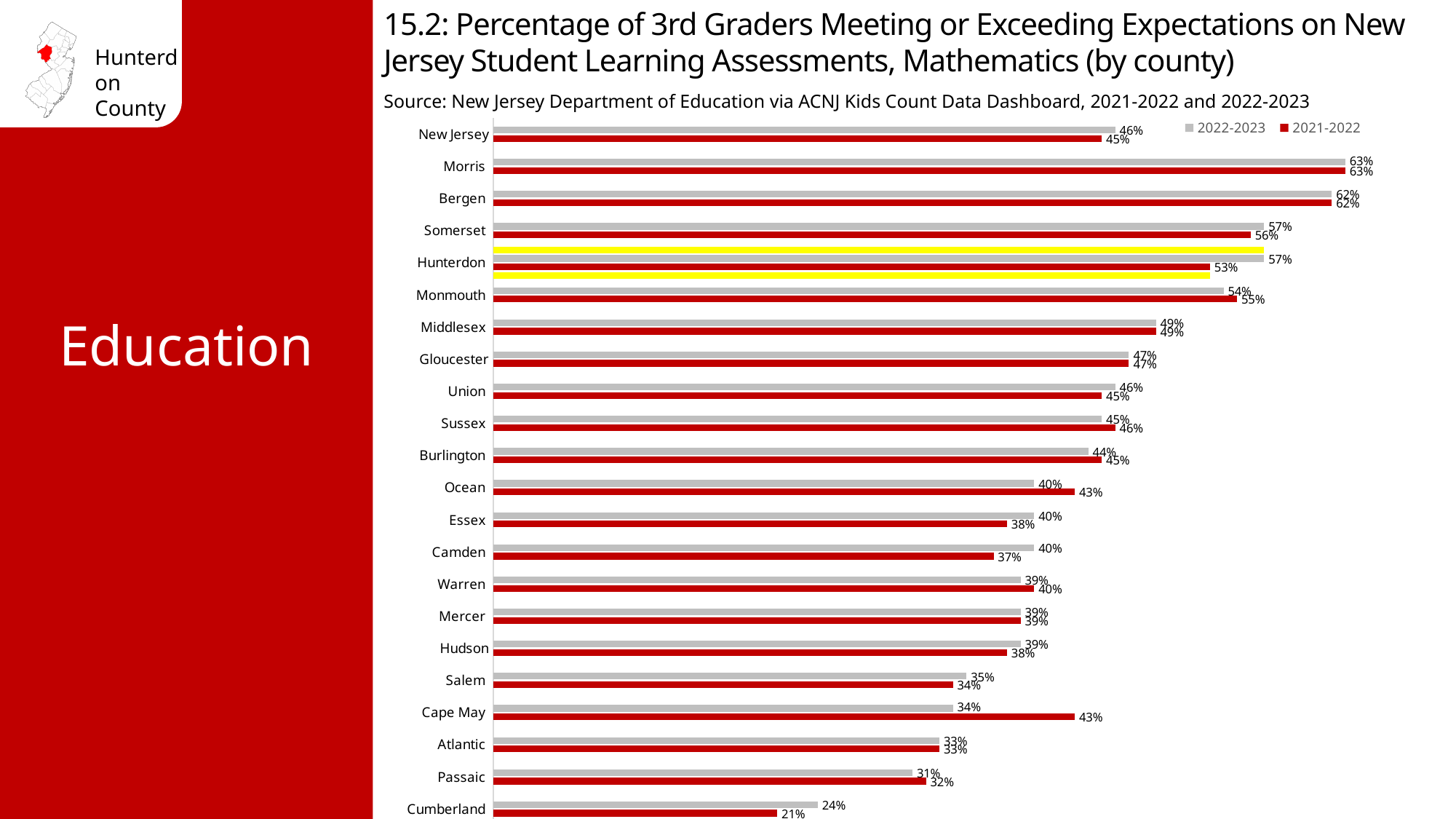
Which county has the highest 2022-2023 value? Morris How many counties or regions are listed on the chart? 22 What is the 2022-2023 value for New Jersey? 46% What kind of chart is shown on the slide? Bar chart What is the difference between Hunterdon's 2022-2023 and 2021-2022 values? 4 percentage points Which is larger for Ocean: the 2022-2023 value or the 2021-2022 value? 2021-2022 What is the difference between Cape May's 2021-2022 and 2022-2023 values? 9 percentage points What is the 2022-2023 value for Hunterdon? 57% How many series does the legend list? 2 What is the 2021-2022 value for Cape May? 43% Which county has the lowest 2021-2022 value? Cumberland Which colour represents the 2021-2022 series? Red